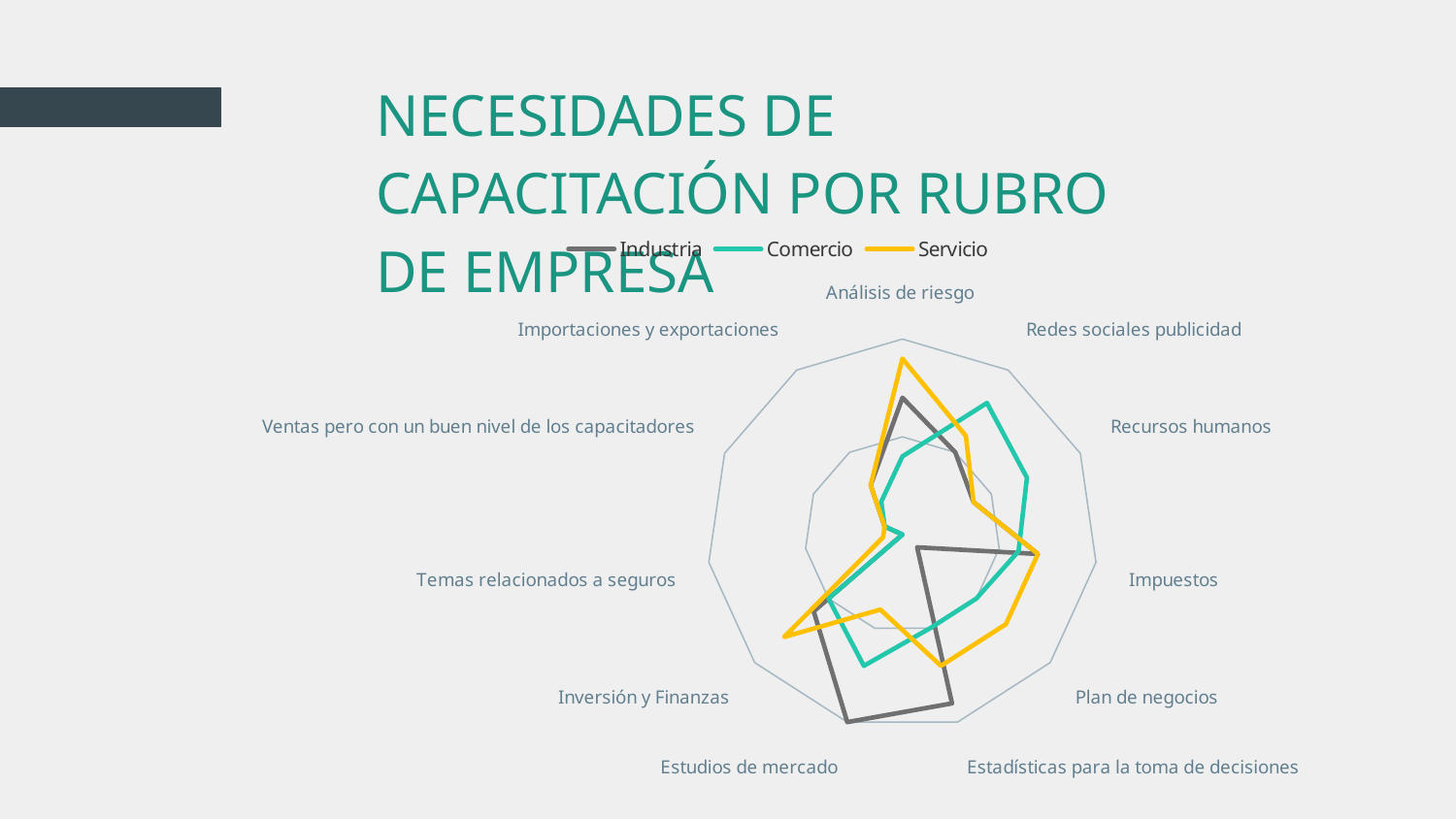
For Inversión y Finanzas, which series has the larger value, Servicio or Industria? Servicio For Impuestos, which series has the larger value, Servicio or Comercio? Servicio For Recursos humanos, which series has the larger value, Comercio or Industria? Comercio In which category does the Industria series reach its highest value? Estudios de mercado How many series does the legend list? 3 Which series is drawn in yellow in the chart? Servicio What kind of chart is shown on the slide? radar chart How many categories (axes) does the radar chart have? 11 What is the title of the slide containing the chart? NECESIDADES DE CAPACITACIÓN POR RUBRO DE EMPRESA